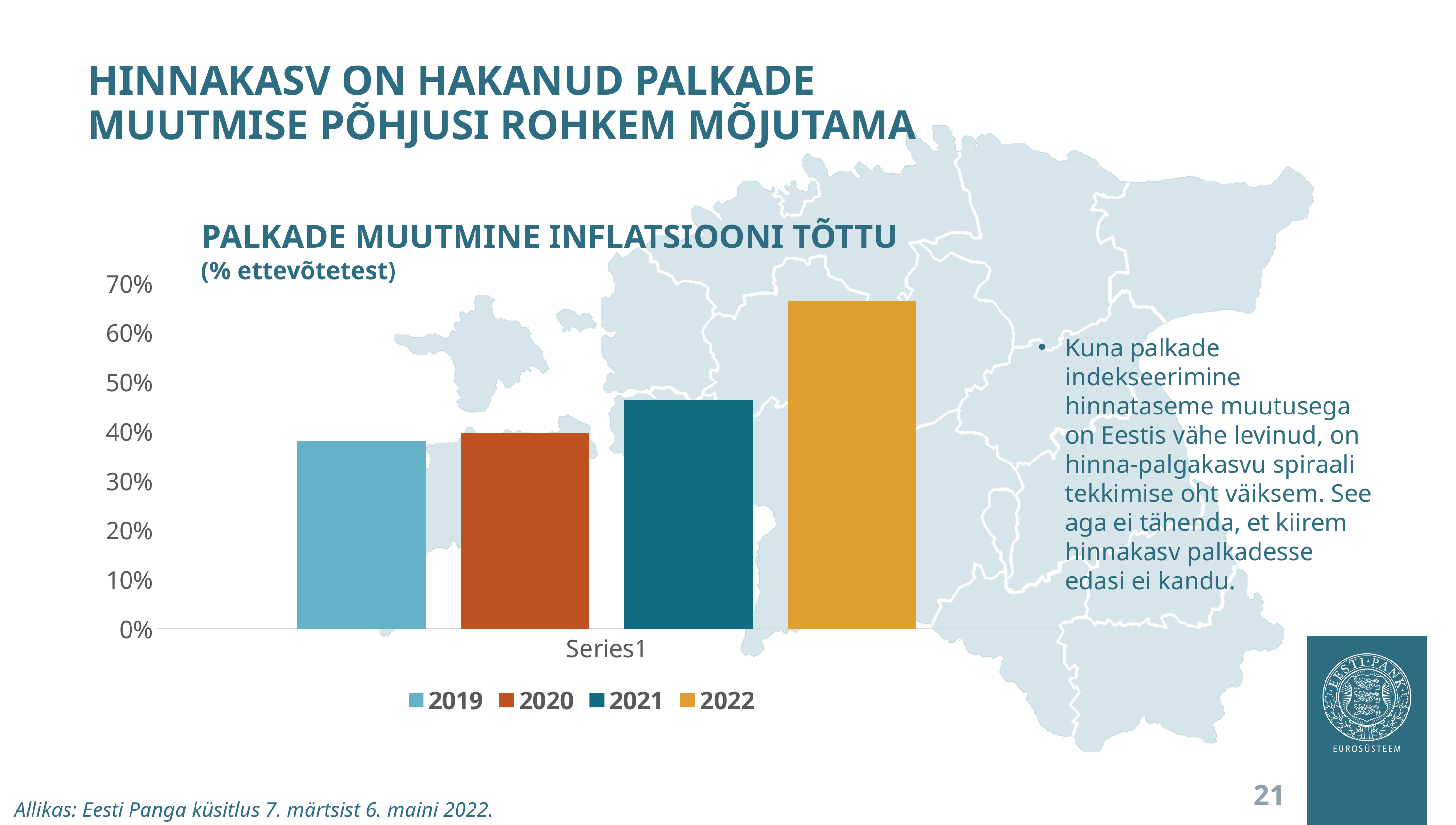
What kind of chart is shown on the slide? bar chart How many entries does the chart legend list? 4 What is the title of the chart? PALKADE MUUTMINE INFLATSIOONI TÕTTU Is the value for 2022 greater or less than 60%? greater How many bars are plotted in the chart? 4 Which year has the highest bar in the chart? 2022 What unit is given in the chart subtitle below the title? % ettevõtetest Which is larger, the value for 2021 or the value for 2020? 2021 Is the value for 2019 greater or less than 30%? greater Do the bar values rise or fall from 2019 to 2022? rise Is the value for 2021 greater or less than 40%? greater